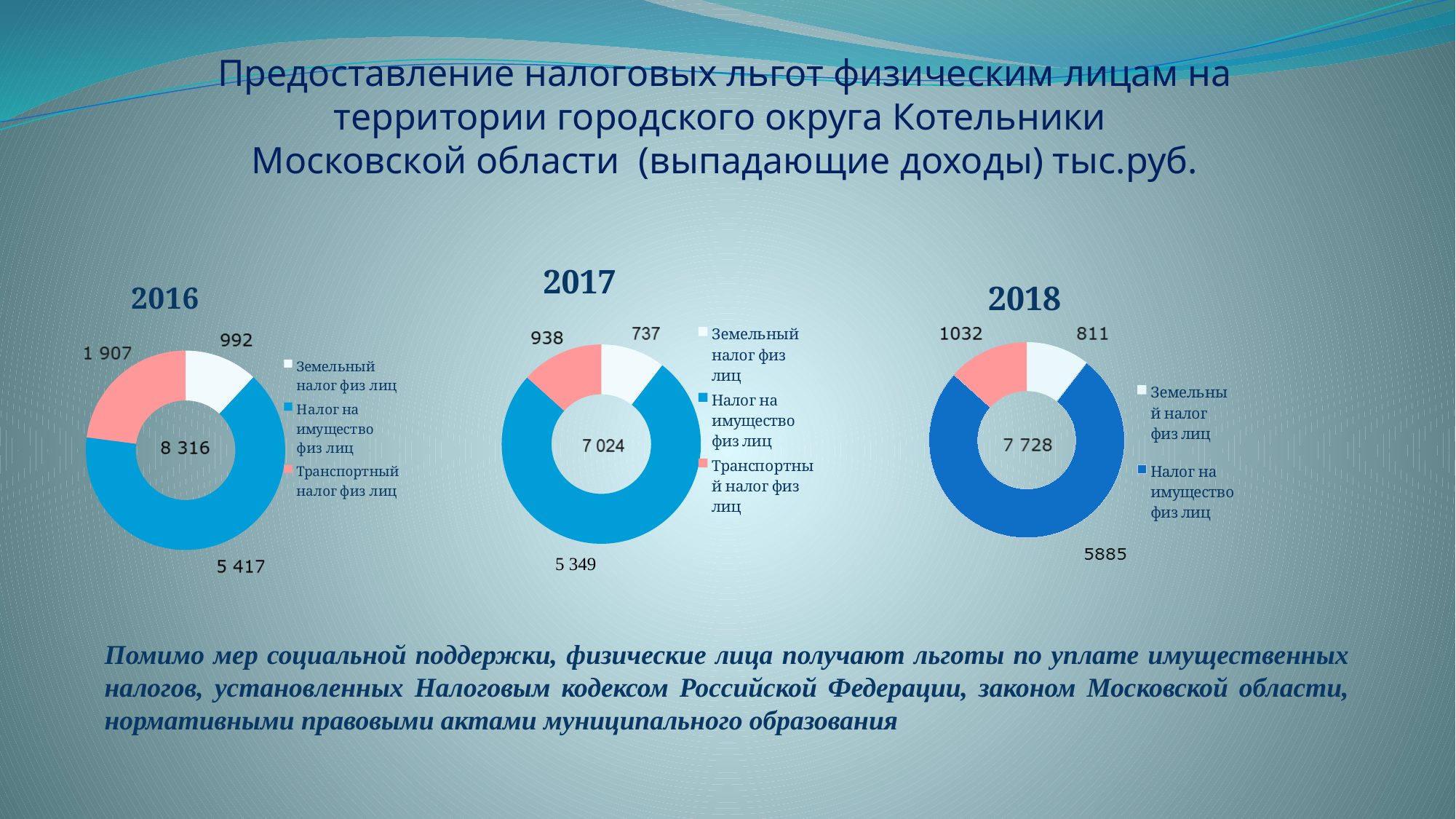
What total is shown in the centre of the 2016 chart? 8 316 What total is shown in the centre of the 2017 chart? 7 024 In the 2017 chart, what is the value for Транспортный налог физ лиц? 938 Which is larger: Налог на имущество физ лиц in 2018 or in 2017? 2018 In the 2018 chart, what is the value for Земельный налог физ лиц? 811 In the 2018 chart, which category has the largest value? Налог на имущество физ лиц How many slices does the 2016 chart have? 3 In the 2017 chart, which category has the smallest value? Земельный налог физ лиц What type of chart is used for the 2017 data? Doughnut chart In the 2016 chart, what is the value for Налог на имущество физ лиц? 5 417 How many entries does the legend of the 2018 chart list? 2 In the 2016 chart, what is the difference between Транспортный налог физ лиц and Земельный налог физ лиц? 915